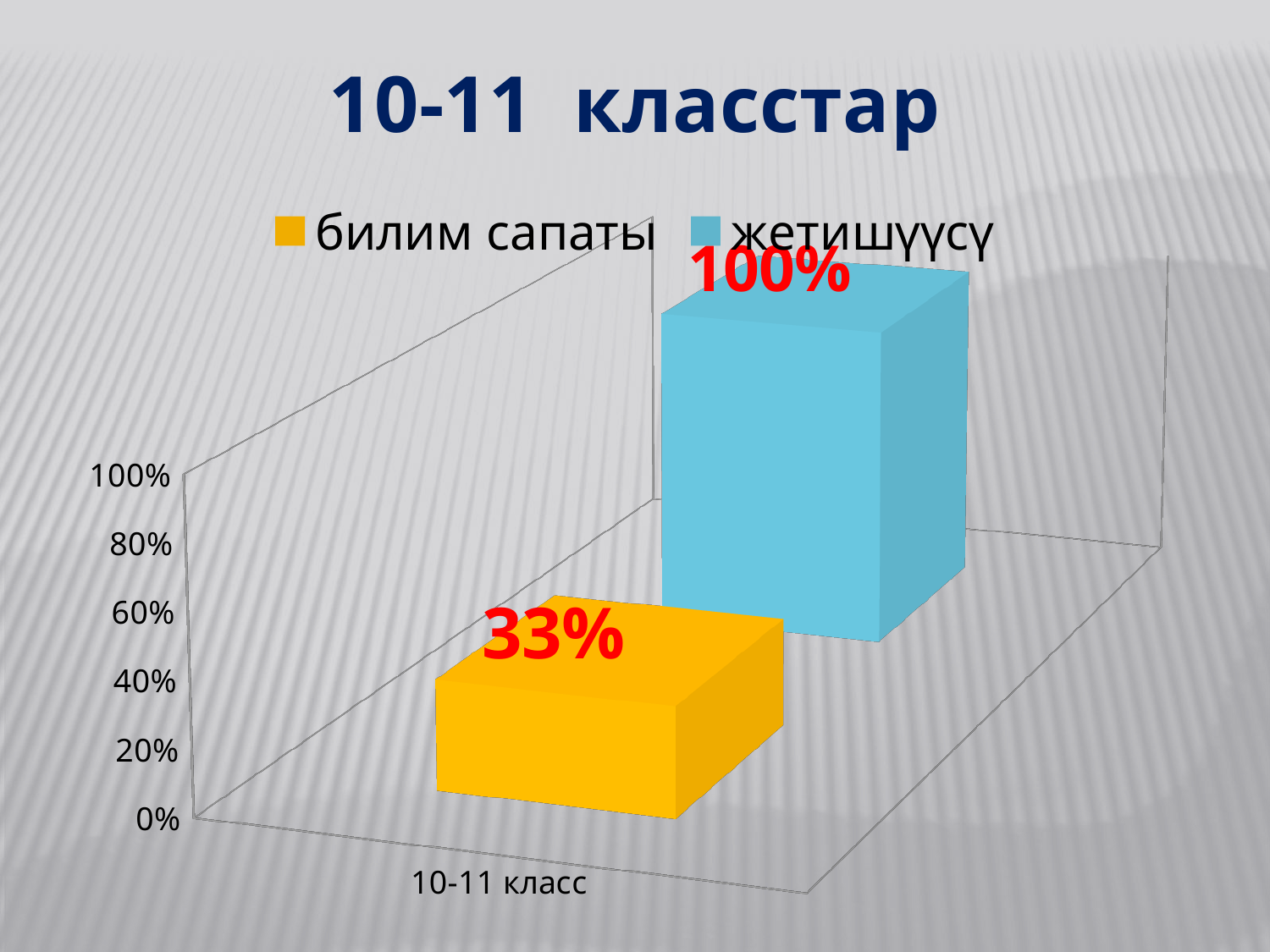
What is the title of the slide? 10-11 класстар What is the value for жетишүүсү for 10-11 класс? 100% What is the value for билим сапаты for 10-11 класс? 33% Which series has the lowest value on the chart? билим сапаты What kind of chart is shown on the slide? bar chart Is the value for билим сапаты greater or less than 40%? less What is the difference between the жетишүүсү value and the билим сапаты value? 67% How many series does the legend list? 2 What colour is the bar for жетишүүсү? blue Which series has the higher value: билим сапаты or жетишүүсү? жетишүүсү How many categories are shown on the x axis? 1 What is the category label on the x axis? 10-11 класс